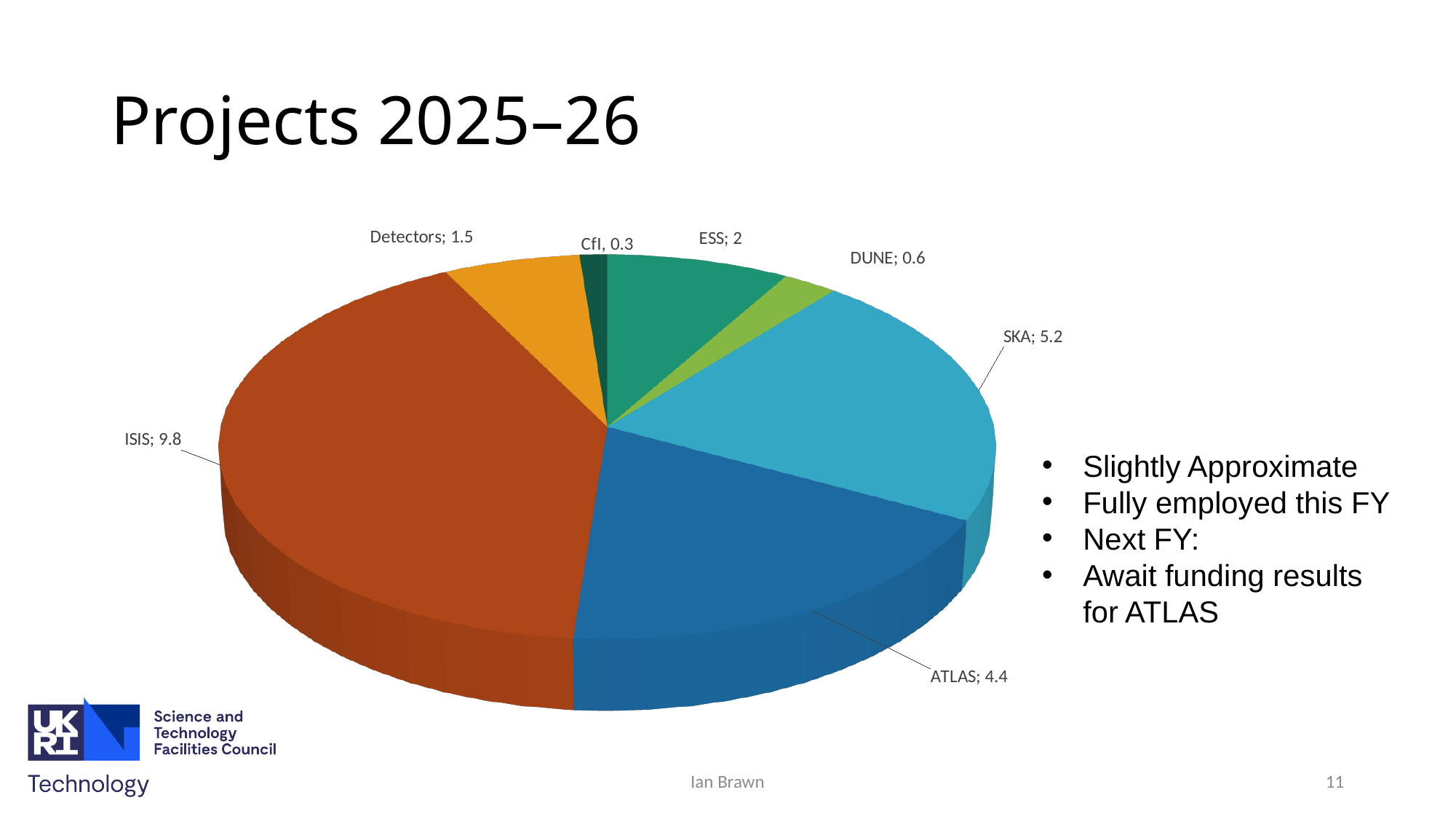
What is the total of all the values shown in the pie chart? 23.8 What value is shown for Detectors in the pie chart? 1.5 What value is shown for ISIS in the pie chart? 9.8 What kind of chart is shown on the slide? Pie chart What is the difference between the values for ISIS and SKA? 4.6 What is the difference between the values for ESS and DUNE? 1.4 What value is shown for CfI in the pie chart? 0.3 What value is shown for SKA in the pie chart? 5.2 How many projects (slices) are shown in the pie chart? 7 Which project has the smallest slice of the pie chart? CfI Which project has the largest slice of the pie chart? ISIS Which is larger, the value for SKA or the value for ATLAS? SKA